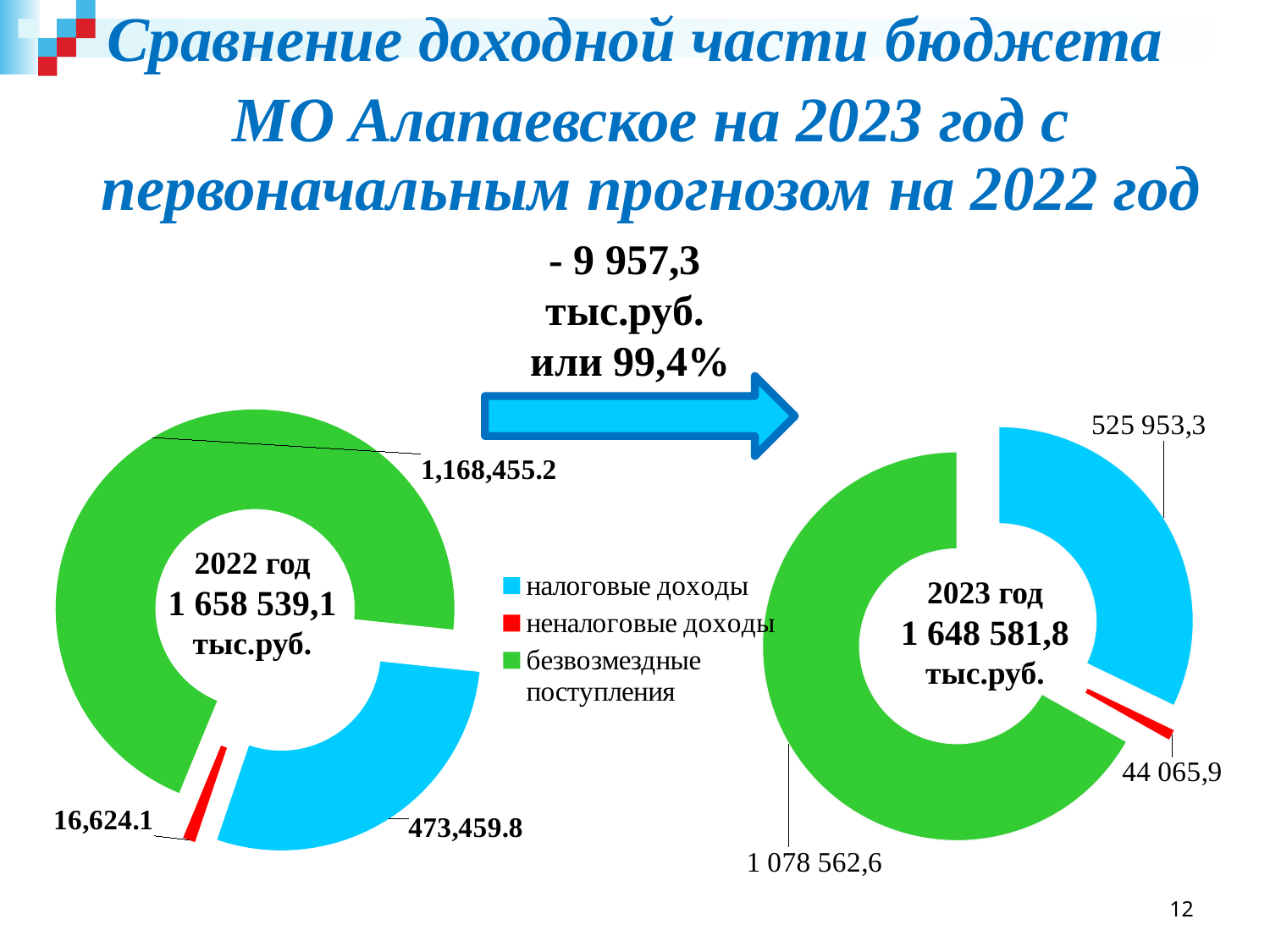
On the 2022 год chart, which category has the smallest value? неналоговые доходы On the 2022 год chart, what is the value for неналоговые доходы? 16,624.1 Which is larger: налоговые доходы on the 2022 год chart or налоговые доходы on the 2023 год chart? 2023 год On the 2022 год chart, what is the value for безвозмездные поступления? 1,168,455.2 On the 2023 год chart, what is the value for налоговые доходы? 525 953,3 On the 2022 год chart, what is the value for налоговые доходы? 473,459.8 What kind of chart is the 2023 год chart? doughnut chart On the 2023 год chart, what is the difference between безвозмездные поступления and налоговые доходы? 552 609,3 On the 2023 год chart, what is the value for неналоговые доходы? 44 065,9 What colour represents неналоговые доходы in the legend? red How many categories does the legend list for the charts? 3 On the 2023 год chart, which category has the largest value? безвозмездные поступления